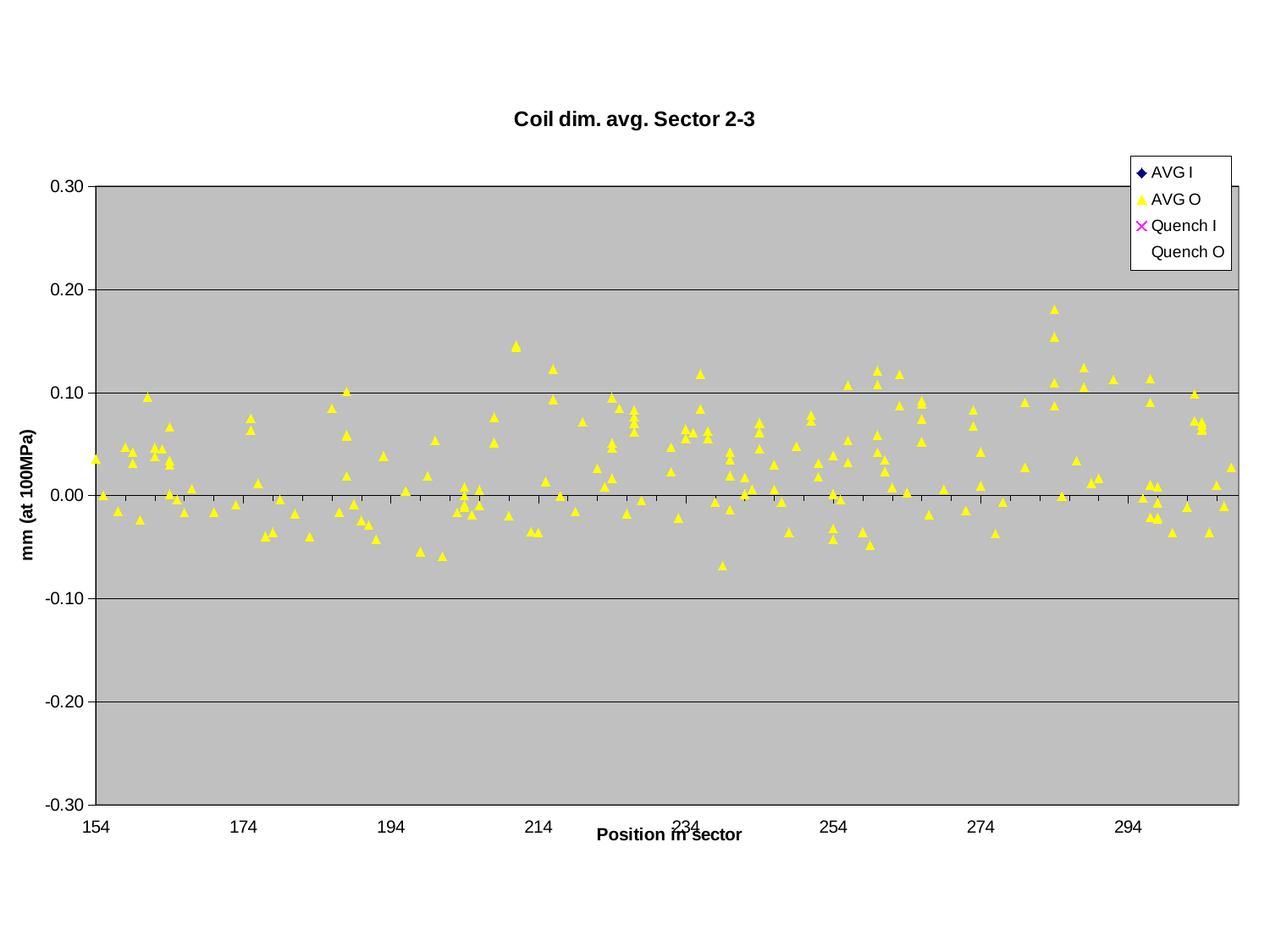
What kind of chart is shown on the slide? scatter chart Is the highest plotted AVG O value greater or less than 0.20? less What is the title of the chart? Coil dim. avg. Sector 2-3 What is the label of the y axis? mm (at 100MPa) How many series does the legend list? 4 Is the lowest plotted AVG O value greater or less than 0.00? less Is the highest plotted AVG O value greater or less than 0.10? greater Which series is plotted with yellow triangle markers? AVG O